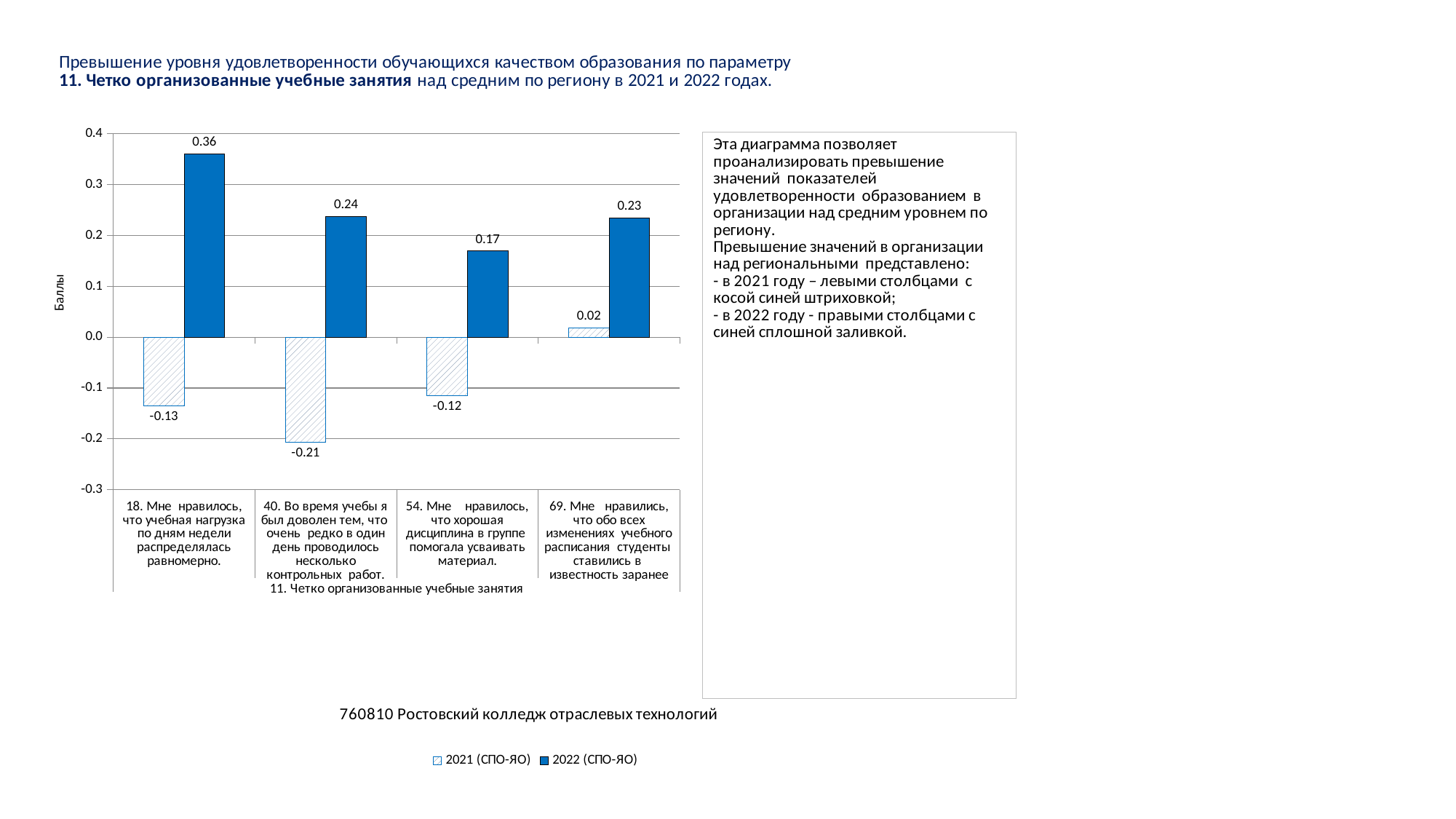
What is the label of the vertical axis of the chart? Баллы What is the value for 2022 (СПО-ЯО) for category 54 (Мне нравилось, что хорошая дисциплина в группе помогала усваивать материал)? 0.17 Which is larger for category 54: the 2021 (СПО-ЯО) value or the 2022 (СПО-ЯО) value? 2022 (СПО-ЯО) What is the value for 2021 (СПО-ЯО) for category 69 (Мне нравились, что обо всех изменениях учебного расписания студенты ставились в известность заранее)? 0.02 Which category has the highest value for the 2022 (СПО-ЯО) series? 18. Мне нравилось, что учебная нагрузка по дням недели распределялась равномерно. What kind of chart is shown on the slide? Bar chart Which category has the lowest value for the 2021 (СПО-ЯО) series? 40. Во время учебы я был доволен тем, что очень редко в один день проводилось несколько контрольных работ. What is the difference between the 2022 (СПО-ЯО) and 2021 (СПО-ЯО) values for category 18? 0.49 How many series does the legend list? 2 What is the value for 2022 (СПО-ЯО) for category 18 (Мне нравилось, что учебная нагрузка по дням недели распределялась равномерно)? 0.36 How many categories are shown on the x axis of the chart? 4 What is the value for 2021 (СПО-ЯО) for category 40 (Во время учебы я был доволен тем, что очень редко в один день проводилось несколько контрольных работ)? -0.21